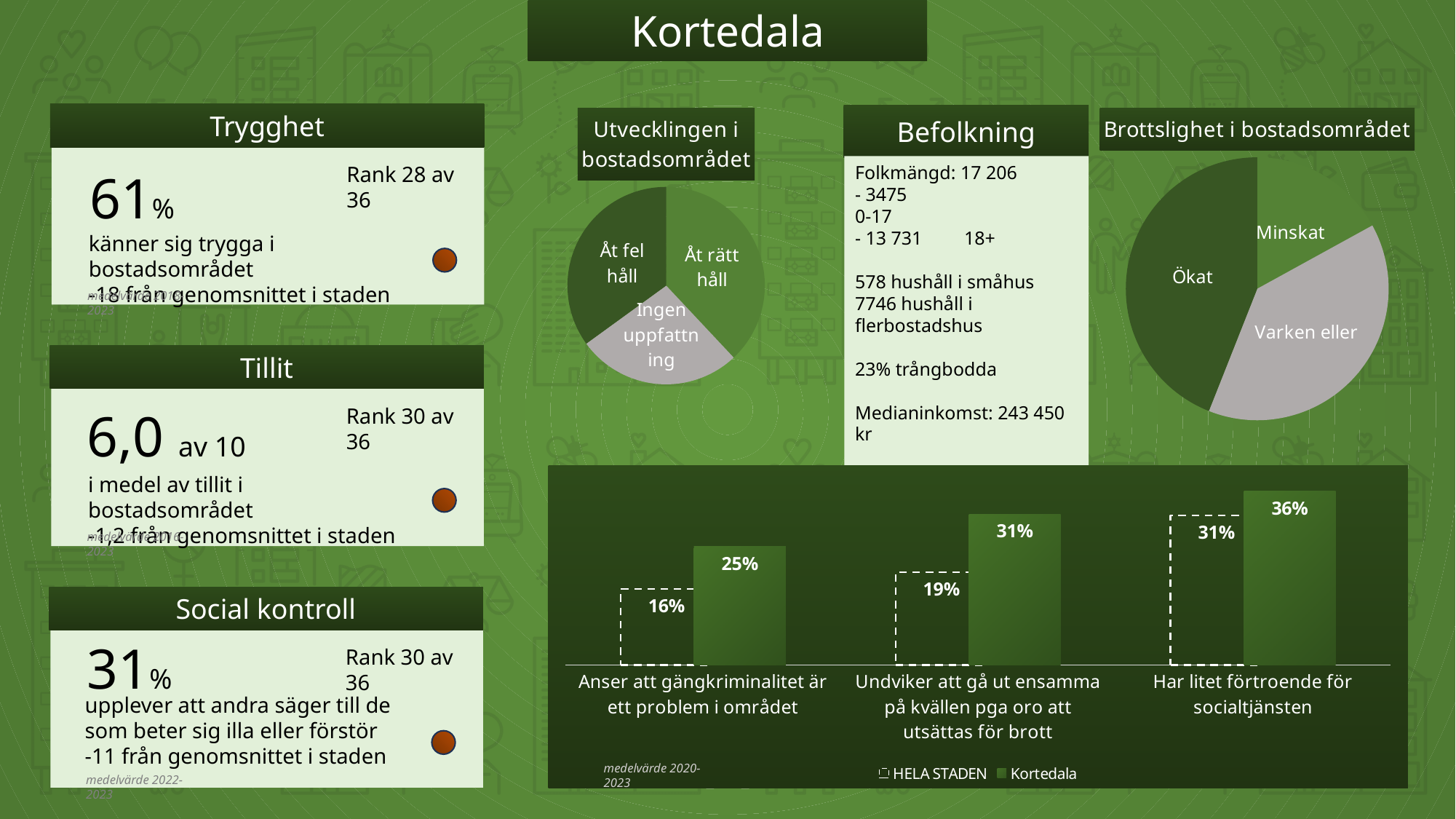
In the bar chart at the bottom of the slide, what is the Kortedala value for 'Har litet förtroende för socialtjänsten'? 36% In the bar chart at the bottom of the slide, what is the HELA STADEN value for 'Undviker att gå ut ensamma på kvällen pga oro att utsättas för brott'? 19% How many categories are shown in the bar chart at the bottom of the slide? 3 In the bar chart at the bottom of the slide, what is the Kortedala value for 'Anser att gängkriminalitet är ett problem i området'? 25% How many slices does the 'Utvecklingen i bostadsområdet' pie chart have? 3 In the 'Brottslighet i bostadsområdet' pie chart, which slice is the largest? Ökat In the bar chart at the bottom of the slide, which is larger for 'Har litet förtroende för socialtjänsten': HELA STADEN or Kortedala? Kortedala In the bar chart at the bottom of the slide, which category has the highest Kortedala value? Har litet förtroende för socialtjänsten What kind of chart is 'Brottslighet i bostadsområdet'? Pie chart In the bar chart at the bottom of the slide, which category has the lowest HELA STADEN value? Anser att gängkriminalitet är ett problem i området How many series does the legend of the bar chart at the bottom of the slide list? 2 In the bar chart at the bottom of the slide, what is the difference between the Kortedala and HELA STADEN values for 'Undviker att gå ut ensamma på kvällen pga oro att utsättas för brott'? 12%